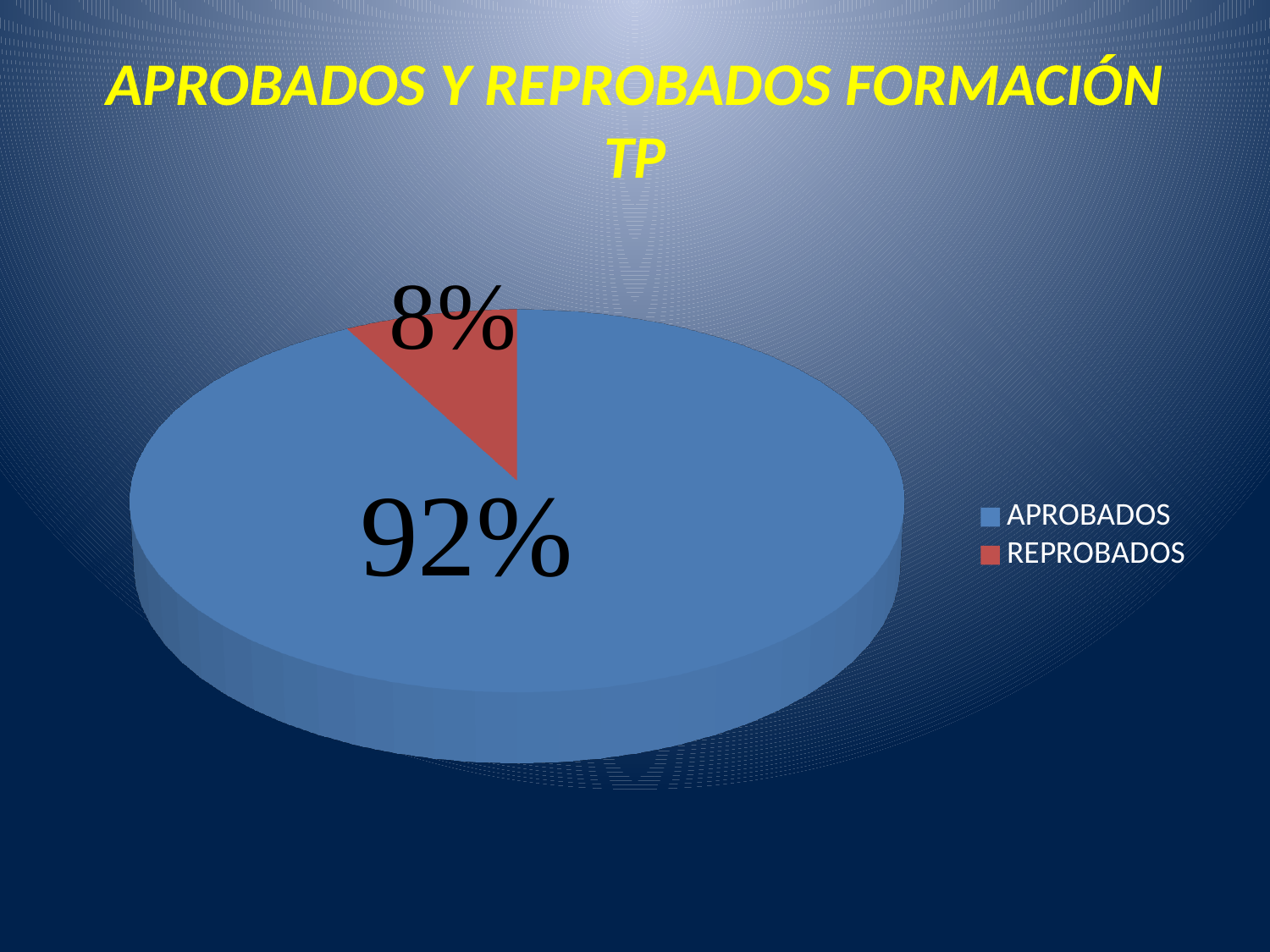
What share of the pie does the REPROBADOS slice represent? 8% Which category has the largest share of the pie? APROBADOS What colour is the REPROBADOS slice? Red What kind of chart is shown on the slide? Pie chart What is the difference in percentage points between APROBADOS and REPROBADOS? 84 How many entries does the legend list? 2 What percentage of the pie is APROBADOS? 92% Which category has the smallest share of the pie? REPROBADOS Which is larger, the share for APROBADOS or the share for REPROBADOS? APROBADOS How many categories does the pie chart show? 2 What percentage of the pie is REPROBADOS? 8% What is the title of the chart? APROBADOS Y REPROBADOS FORMACIÓN TP